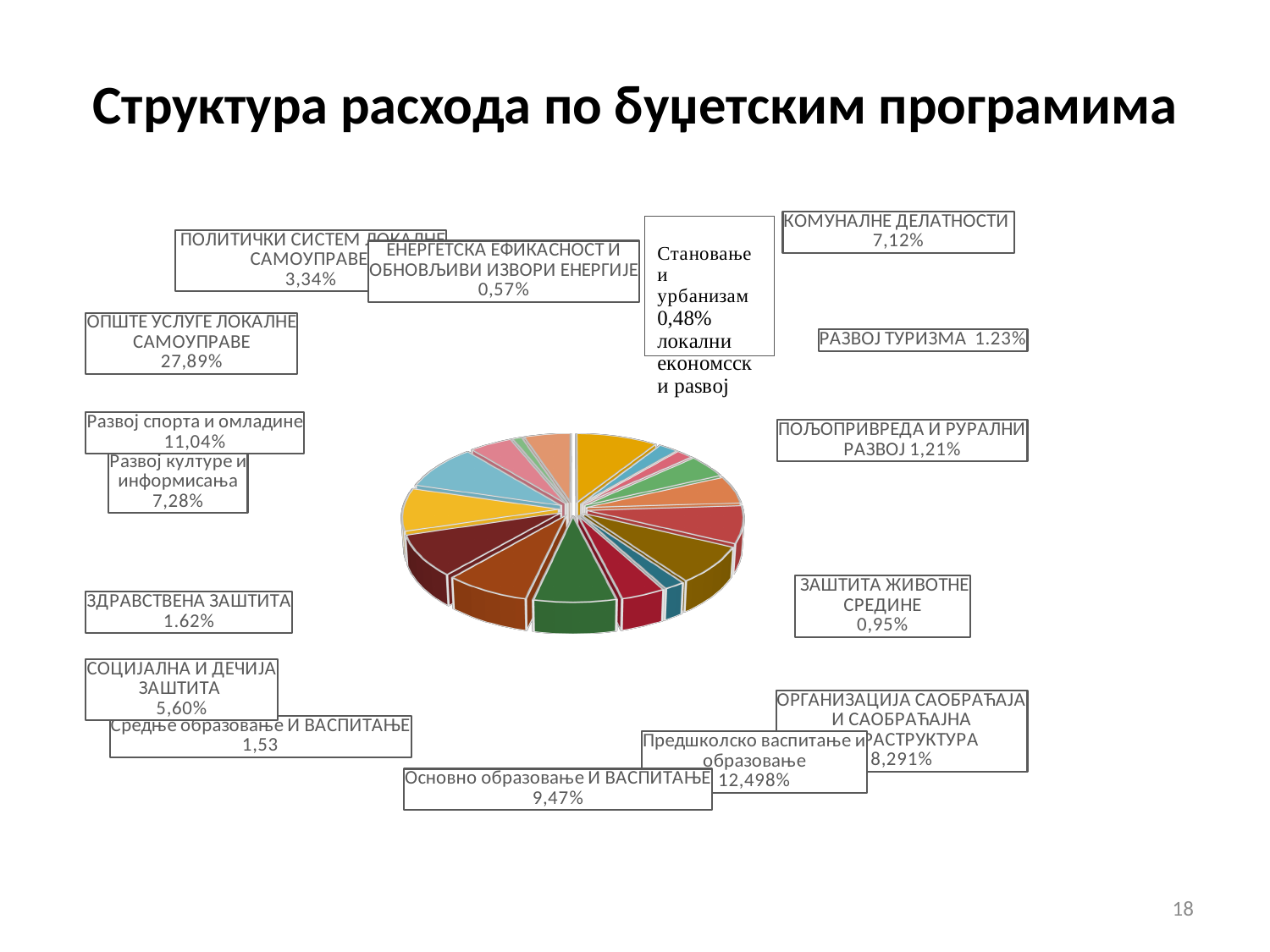
What share is shown for КОМУНАЛНЕ ДЕЛАТНОСТИ? 7,12% What share is shown for ОПШТЕ УСЛУГЕ ЛОКАЛНЕ САМОУПРАВЕ? 27,89% What kind of chart is shown on the slide? Pie chart What share is shown for ЗАШТИТА ЖИВОТНЕ СРЕДИНЕ? 0,95% What is the title of the chart on the slide? Структура расхода по буџетским програмима Which has the larger share: КОМУНАЛНЕ ДЕЛАТНОСТИ or Развој културе и информисања? Развој културе и информисања What is the difference in percentage points between ОПШТЕ УСЛУГЕ ЛОКАЛНЕ САМОУПРАВЕ (27,89%) and Развој спорта и омладине (11,04%)? 16,85 What share is shown for ОРГАНИЗАЦИЈА САОБРАЋАЈА И САОБРАЋАЈНА ИНФРАСТРУКТУРА? 8,291% Which has the larger share: Основно образовање И ВАСПИТАЊЕ or Развој спорта и омладине? Развој спорта и омладине Which program has the largest share of expenditure in the pie chart? ОПШТЕ УСЛУГЕ ЛОКАЛНЕ САМОУПРАВЕ What share is shown for Предшколско васпитање и образовање? 12,498% What share is shown for СОЦИЈАЛНА И ДЕЧИЈА ЗАШТИТА? 5,60%